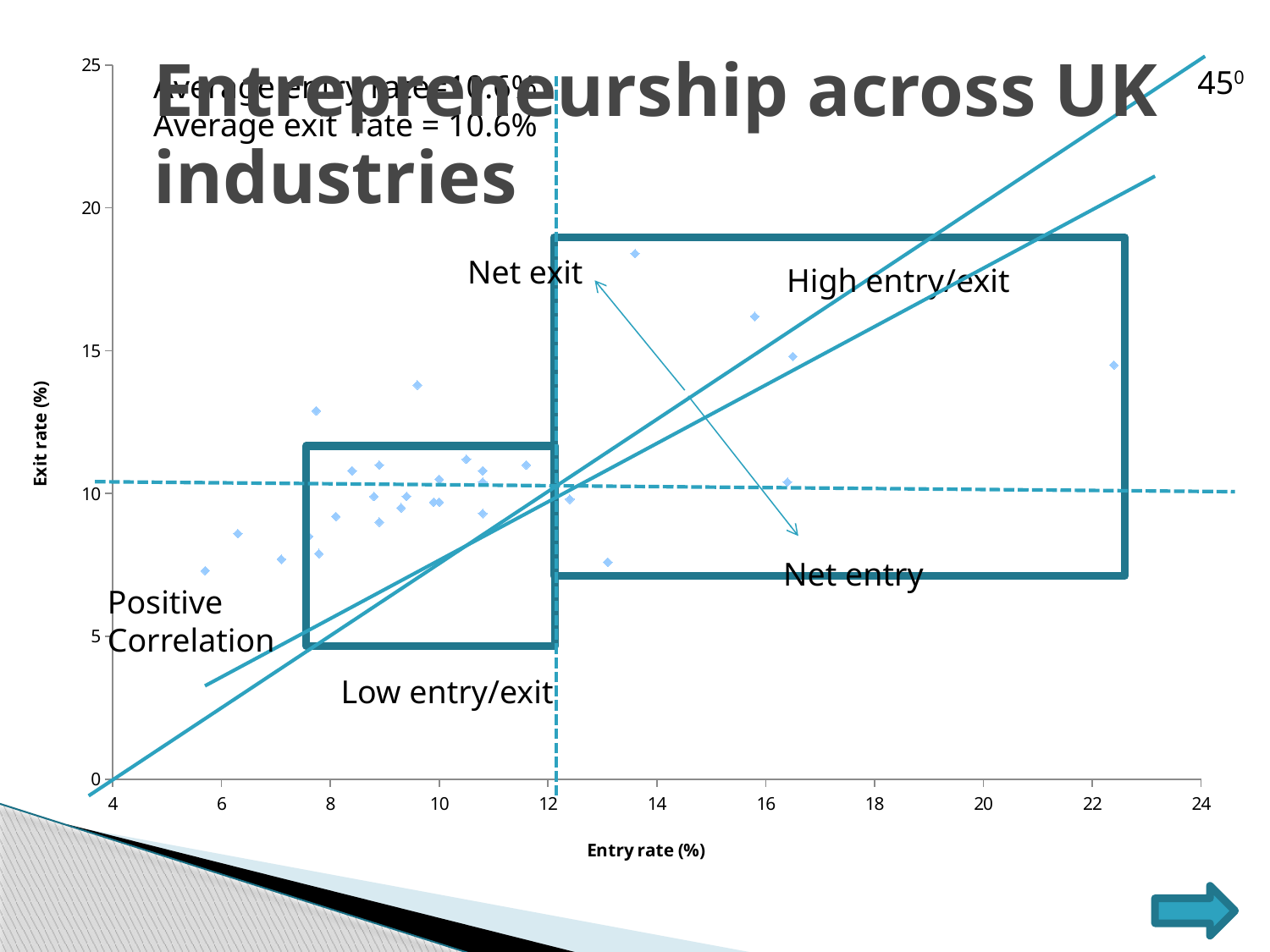
As the entry rate increases along the x axis, do the plotted exit rates generally rise or fall? rise What is the title of the x axis? Entry rate (%) Is the lowest exit rate plotted on the chart greater or less than 5? greater What is the title of the y axis? Exit rate (%) Is the highest exit rate plotted on the chart greater or less than 15? greater Is the average exit rate stated on the slide greater or less than 10? greater What kind of chart is shown on the slide? scatter chart What average exit rate is stated on the slide? 10.6%